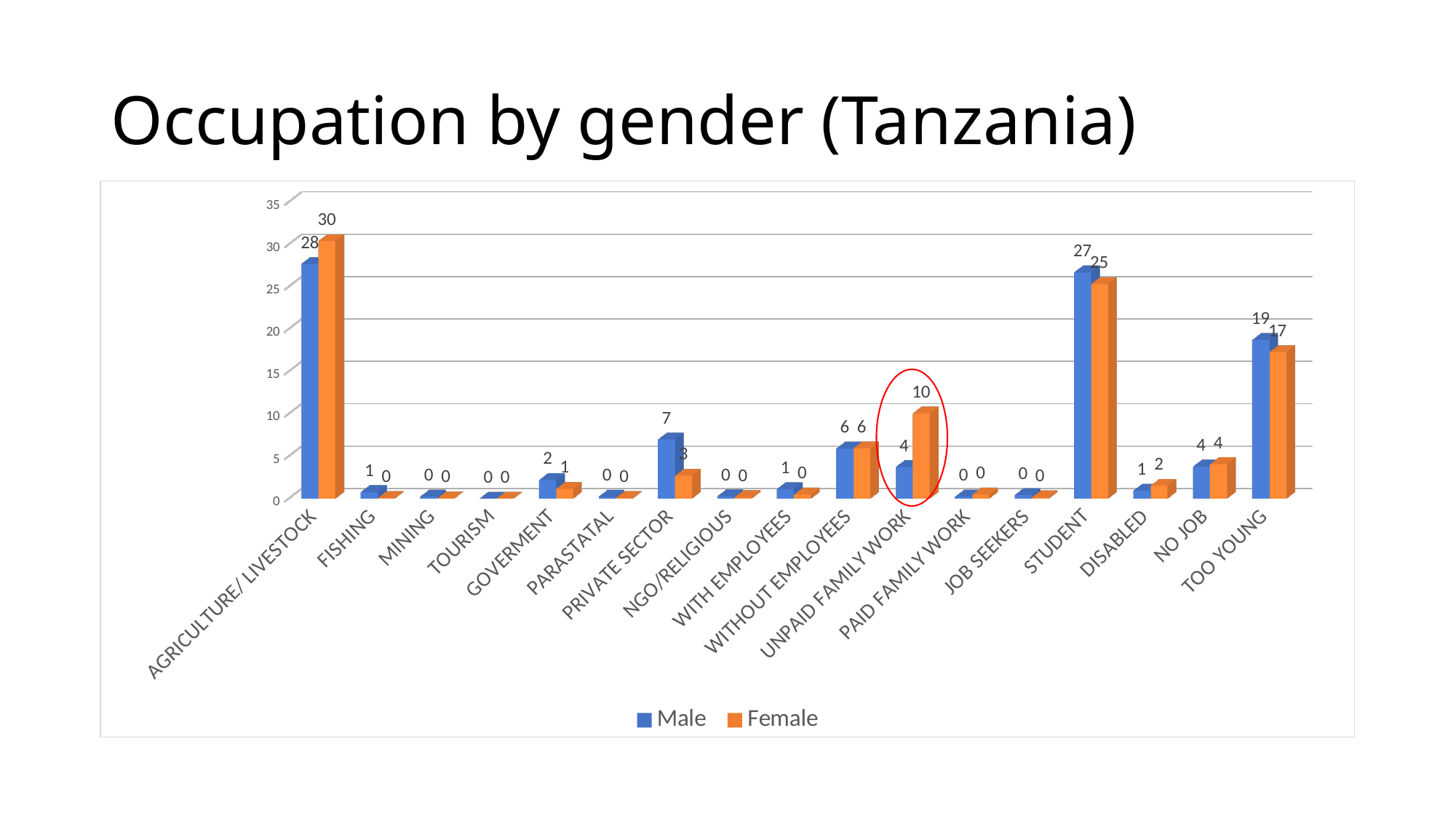
What is the difference between the Male and Female values for STUDENT? 2 How many series does the legend list? 2 What is the Female value for UNPAID FAMILY WORK? 10 What is the Male value for PRIVATE SECTOR? 7 How many occupation categories are shown on the x axis? 17 What kind of chart is shown on the slide? bar chart Which is larger for TOO YOUNG, the Male value or the Female value? Male What is the Male value for AGRICULTURE/ LIVESTOCK? 28 Which category is circled in red on the chart? UNPAID FAMILY WORK Which category has the highest Female value? AGRICULTURE/ LIVESTOCK Is the Male value for STUDENT greater or less than 25? greater What is the difference between the Female and Male values for UNPAID FAMILY WORK? 6